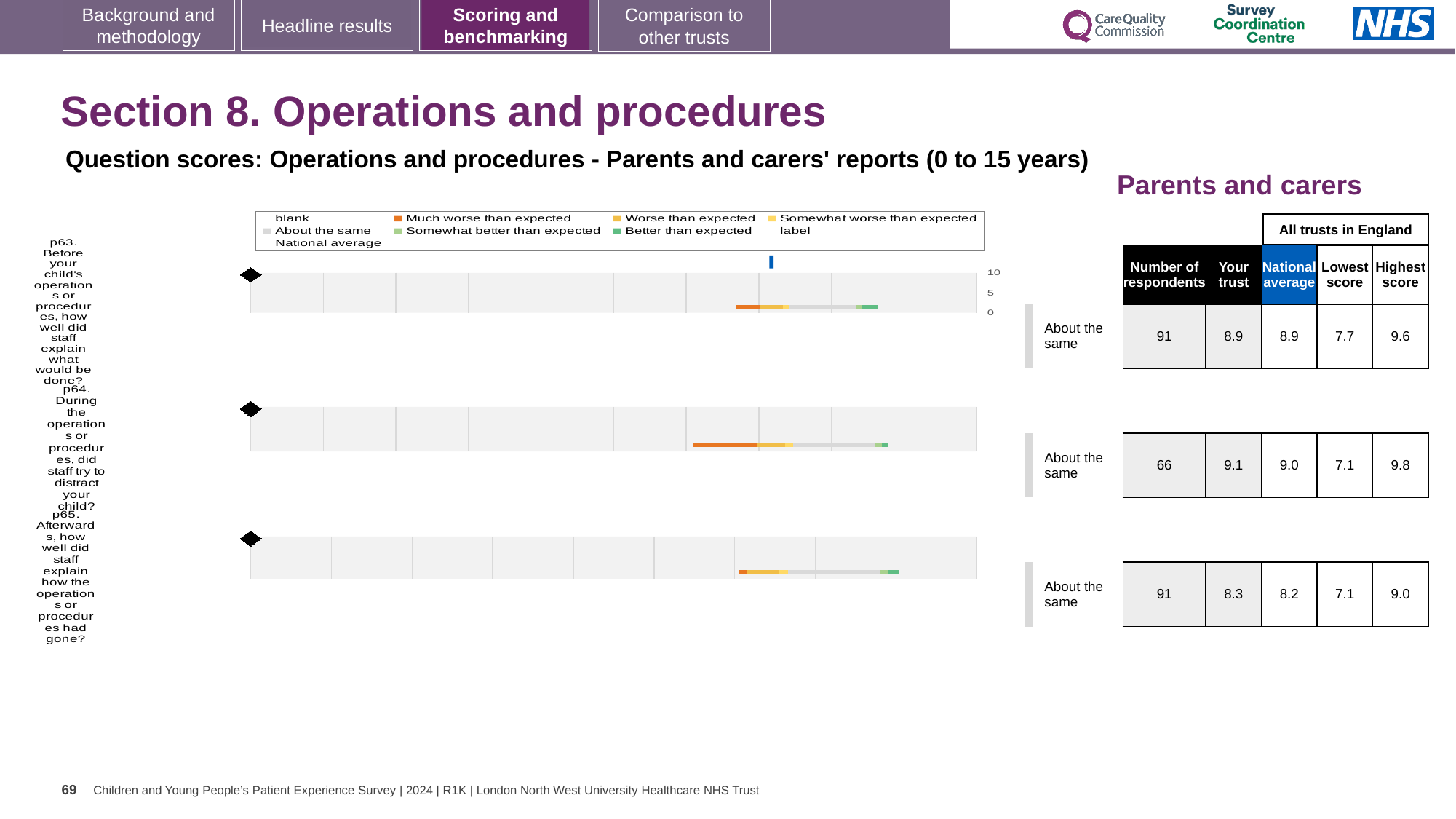
What is the 'Your trust' score for p63 (Before your child's operations or procedures, how well did staff explain what would be done?)? 8.9 What is the national average score for p64 (During the operations or procedures, did staff try to distract your child?)? 9.0 Which question has the lowest 'Your trust' score? p65 How many entries does the chart legend list? 9 What benchmark category is shown for p64? About the same What is the lowest score across all trusts in England for p63? 7.7 What kind of chart is used to show the benchmarking results for each question? bar chart What is the difference between the 'Your trust' score and the national average for p65? 0.1 How many survey questions (rows) are plotted in the benchmarking chart? 3 What is the highest score across all trusts in England for p65 (Afterwards, how well did staff explain how the operations or procedures had gone?)? 9.0 What colour represents 'Much worse than expected' in the chart legend? orange How many respondents answered p64? 66